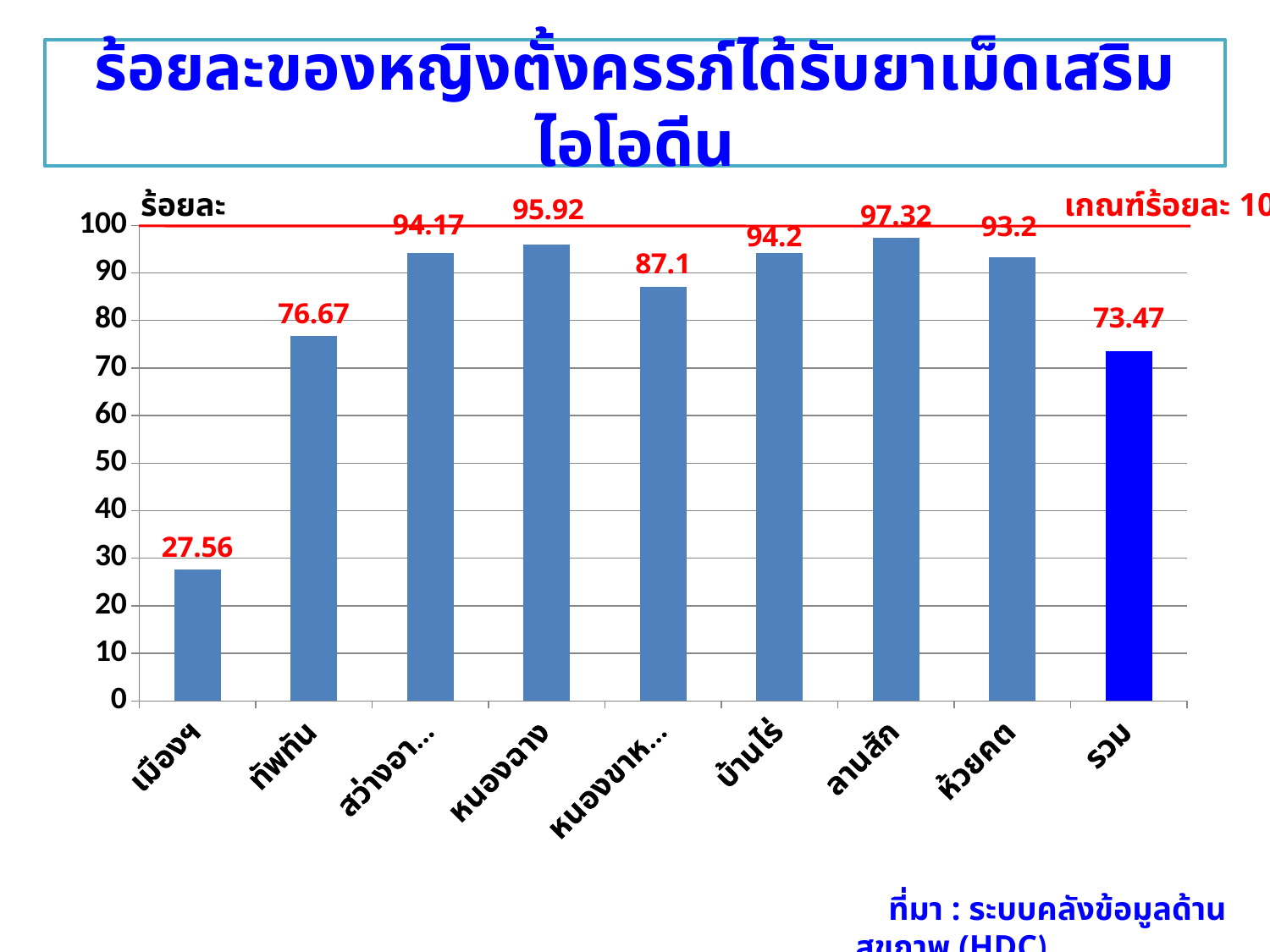
What is the value for เมืองฯ? 27.56 What kind of chart is shown on the slide? bar chart How many bars are shown in the chart? 9 Which is larger, the value for ทัพทัน or the value for ห้วยคต? ห้วยคต Which category's bar is drawn in a different (bright blue) colour from the others? รวม What is the value for ลานสัก? 97.32 What is the value for รวม? 73.47 Which category has the lowest value? เมืองฯ What is the difference between the values for ทัพทัน and รวม? 3.2 What is the value for หนองฉาง? 95.92 Which category has the highest value? ลานสัก What is the difference between the values for ลานสัก and เมืองฯ? 69.76